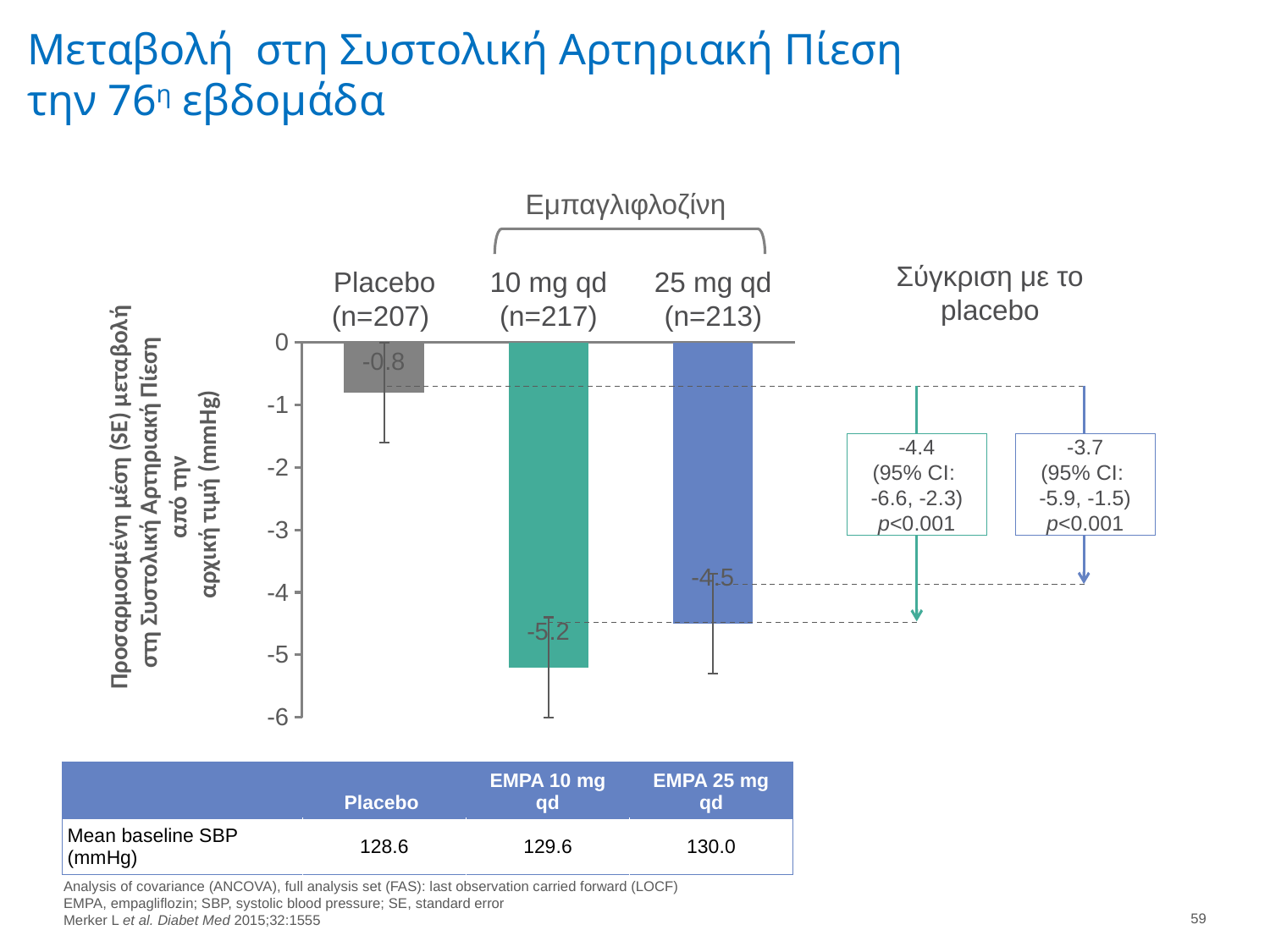
How many treatment groups are plotted in the chart? 3 Which group shows the largest reduction in systolic blood pressure? 10 mg qd Which group has a larger reduction in systolic blood pressure, Placebo or 25 mg qd? 25 mg qd Which group shows the smallest change in systolic blood pressure? Placebo What is the adjusted mean change in systolic blood pressure for the 10 mg qd empagliflozin group? -5.2 Is the value for the 25 mg qd group greater or less than -4? less What is the difference versus placebo shown for the 10 mg qd group? -4.4 What is the adjusted mean change in systolic blood pressure for the 25 mg qd empagliflozin group? -4.5 What is the adjusted mean change in systolic blood pressure for the Placebo group? -0.8 What is the difference between the change for the 10 mg qd group and the 25 mg qd group? 0.7 What kind of chart is shown on the slide? bar chart What is the number of patients (n) in the 25 mg qd group? 213